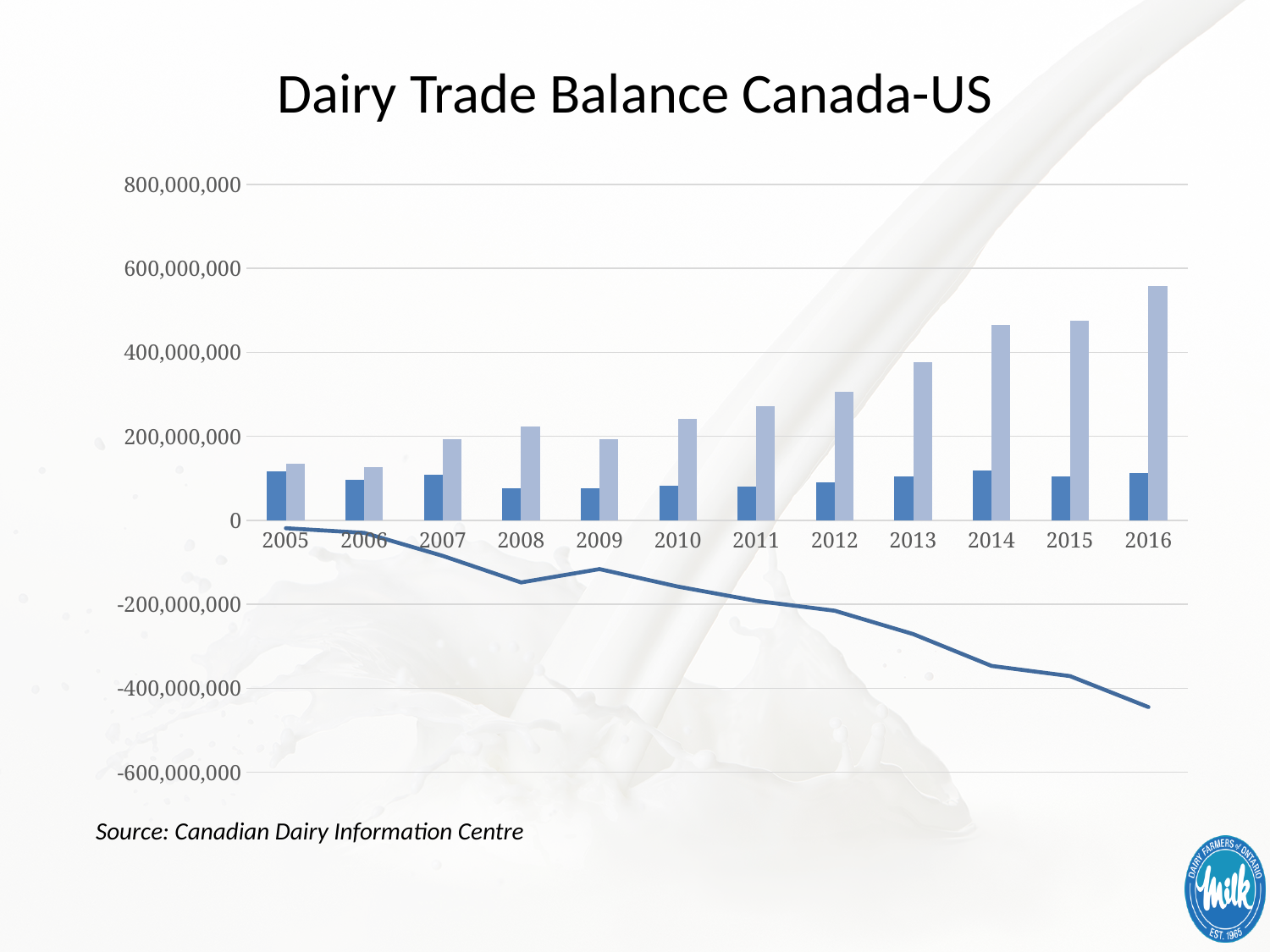
Which year has the taller dark blue bar, 2005 or 2008? 2005 Is the dark blue bar for 2014 greater or less than 200,000,000? less Is the light blue bar for 2016 greater or less than 400,000,000? greater What is the title of the chart? Dairy Trade Balance Canada-US How many years are shown on the x axis of the chart? 12 Do the light blue bars rise or fall from 2009 to 2016? rise Which year has the taller light blue bar, 2013 or 2014? 2014 What kind of chart is shown on the slide? Bar and line chart Is the line value for 2016 greater or less than -400,000,000? less In which year is the light blue bar the tallest? 2016 Does the line rise or fall from 2005 to 2016? fall